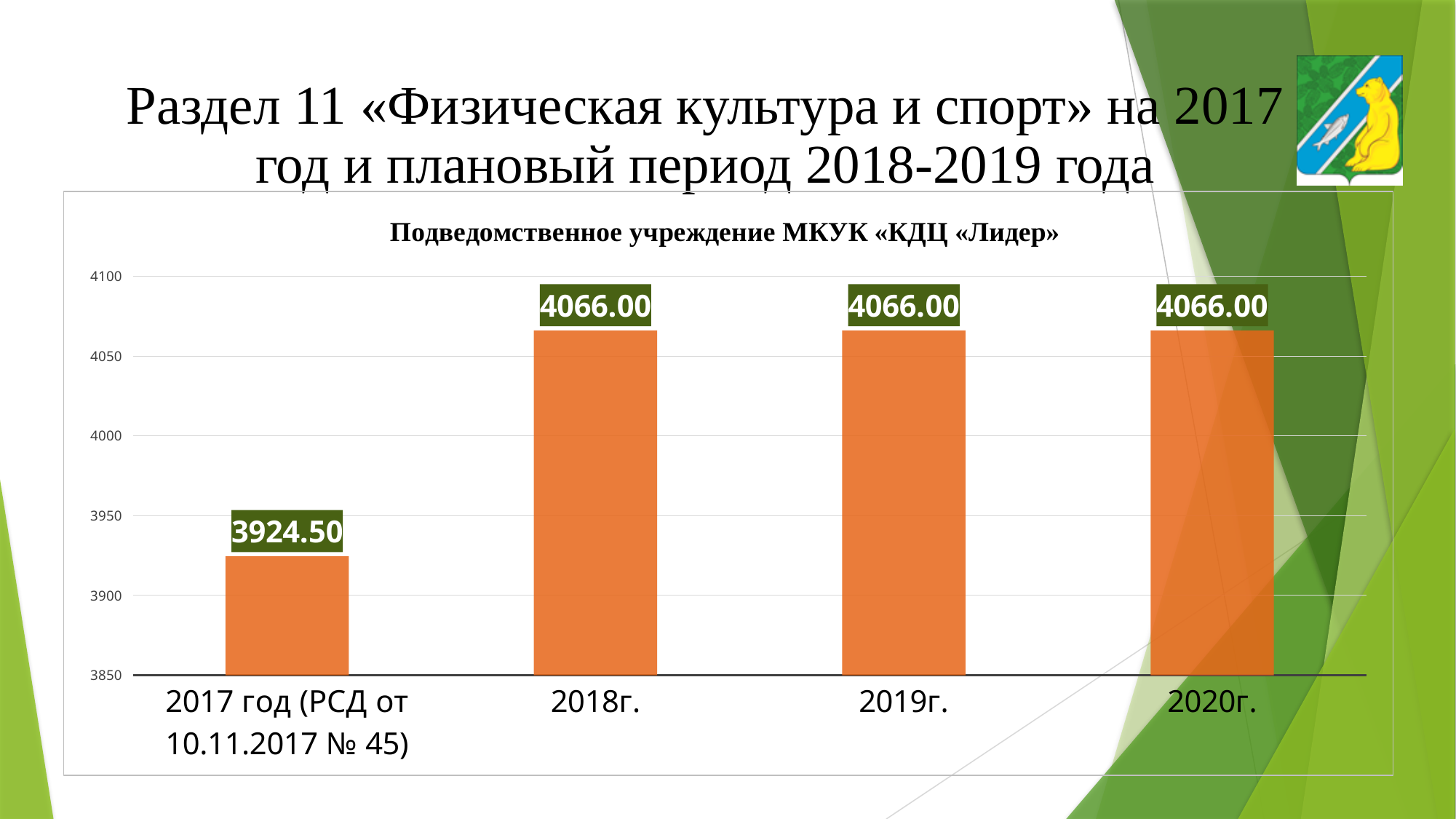
What is the title of the chart? Подведомственное учреждение МКУК «КДЦ «Лидер» What is the value for 2018г.? 4066.00 What is the value for 2020г.? 4066.00 What is the value for the 2017 год (РСД от 10.11.2017 № 45) bar? 3924.50 What is the difference between the values for 2018г. and 2017 год (РСД от 10.11.2017 № 45)? 141.50 Is the value for 2019г. greater or less than 4050? greater Which is larger, the value for 2019г. or the value for 2017 год (РСД от 10.11.2017 № 45)? 2019г. Is the value for 2017 год (РСД от 10.11.2017 № 45) greater or less than 3950? less How many bars are shown in the chart? 4 What kind of chart is shown on the slide? bar chart Which category has the lowest value? 2017 год (РСД от 10.11.2017 № 45) Does the value rise or fall from 2017 год (РСД от 10.11.2017 № 45) to 2018г.? rise